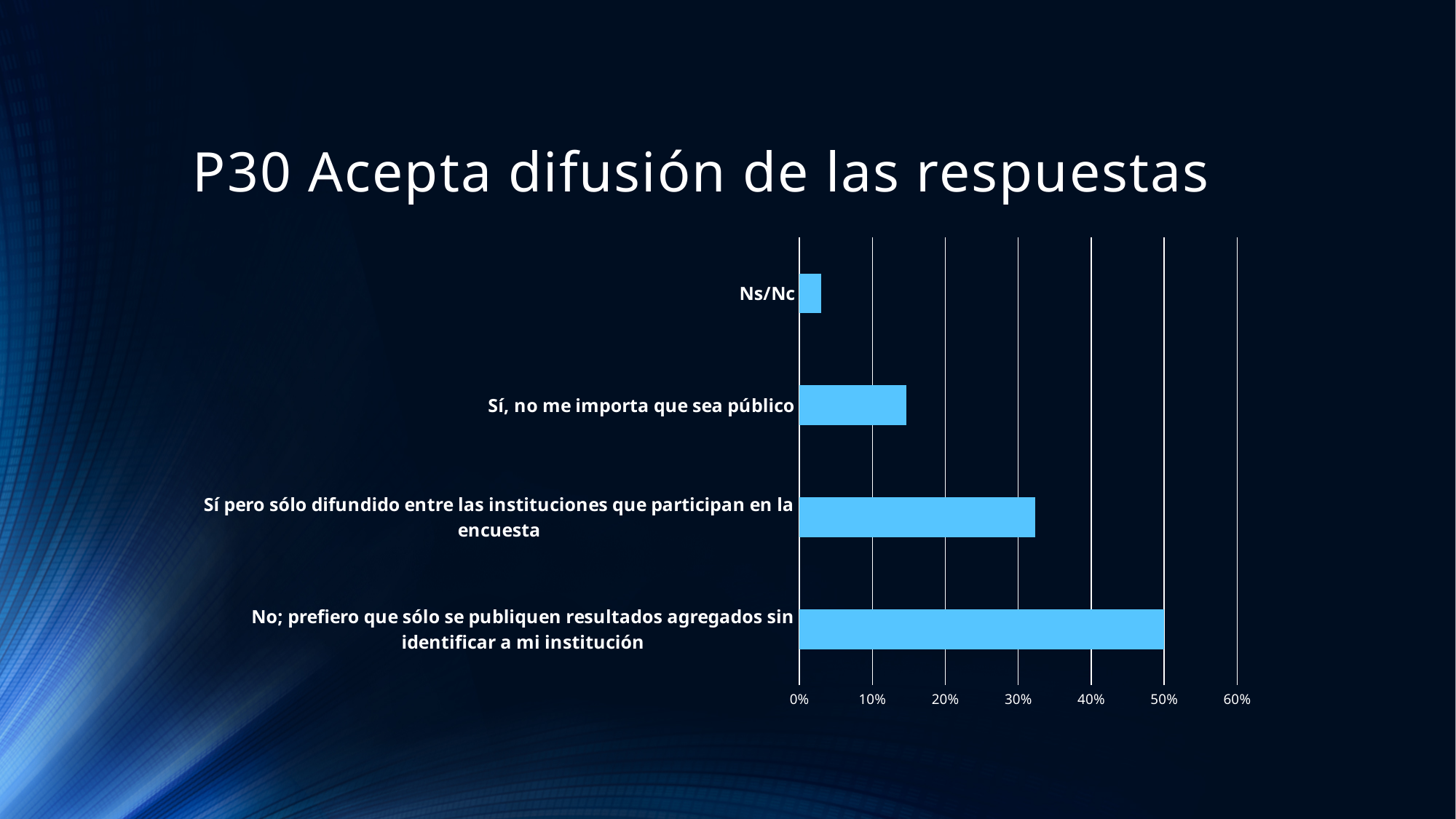
What is the title of the slide containing the chart? P30 Acepta difusión de las respuestas What is the value for 'No; prefiero que sólo se publiquen resultados agregados sin identificar a mi institución'? 50% What is the maximum value shown on the horizontal axis? 60% Is the value for 'Ns/Nc' greater or less than 10%? less Is the value for 'Sí pero sólo difundido entre las instituciones que participan en la encuesta' greater or less than 40%? less How many categories are shown in the chart? 4 Which category has the highest value? No; prefiero que sólo se publiquen resultados agregados sin identificar a mi institución Is the value for 'Sí, no me importa que sea público' greater or less than 20%? less What kind of chart is shown on the slide? bar chart Which is larger: the value for 'Sí, no me importa que sea público' or the value for 'Sí pero sólo difundido entre las instituciones que participan en la encuesta'? Sí pero sólo difundido entre las instituciones que participan en la encuesta Which category has the lowest value? Ns/Nc